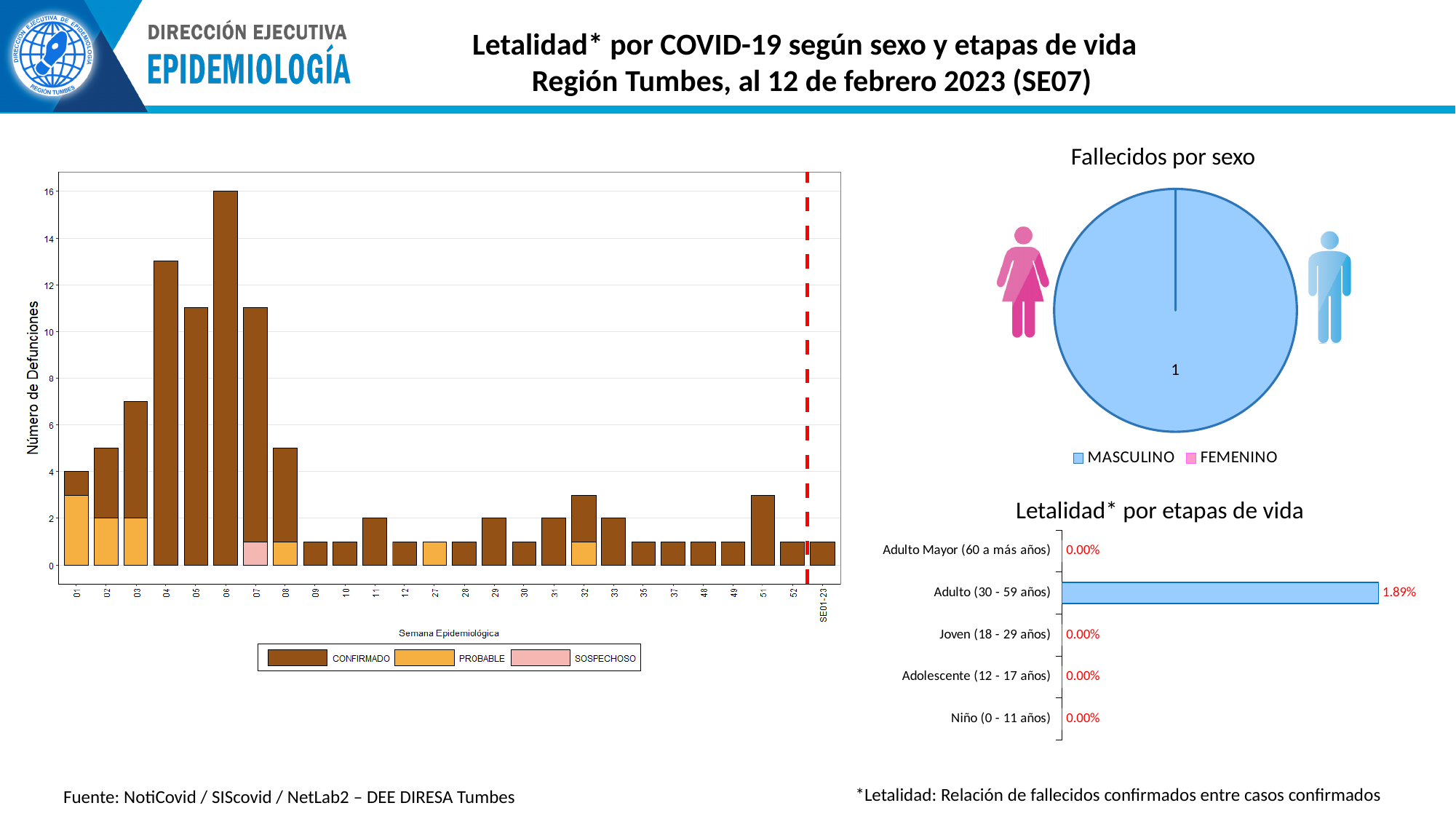
In the 'Letalidad* por etapas de vida' chart, what is the value for Adulto (30 - 59 años)? 1.89% In the 'Letalidad* por etapas de vida' chart, what is the value for Adulto Mayor (60 a más años)? 0.00% In the 'Letalidad* por etapas de vida' chart, which age group has the highest value? Adulto (30 - 59 años) In the stacked bar chart on the left, is the total for week 04 greater or less than 12? greater In the stacked bar chart on the left, what is the total number of deaths for week 06? 16 In the 'Fallecidos por sexo' chart, what value is shown for MASCULINO? 1 How many age-group categories are shown in the 'Letalidad* por etapas de vida' chart? 5 How many series does the legend of the stacked bar chart on the left list? 3 How many entries does the legend of the 'Fallecidos por sexo' chart list? 2 What kind of chart is 'Fallecidos por sexo'? Pie chart What kind of chart is 'Letalidad* por etapas de vida'? Bar chart In the stacked bar chart on the left (Número de Defunciones by Semana Epidemiológica), which week has the highest total? 06